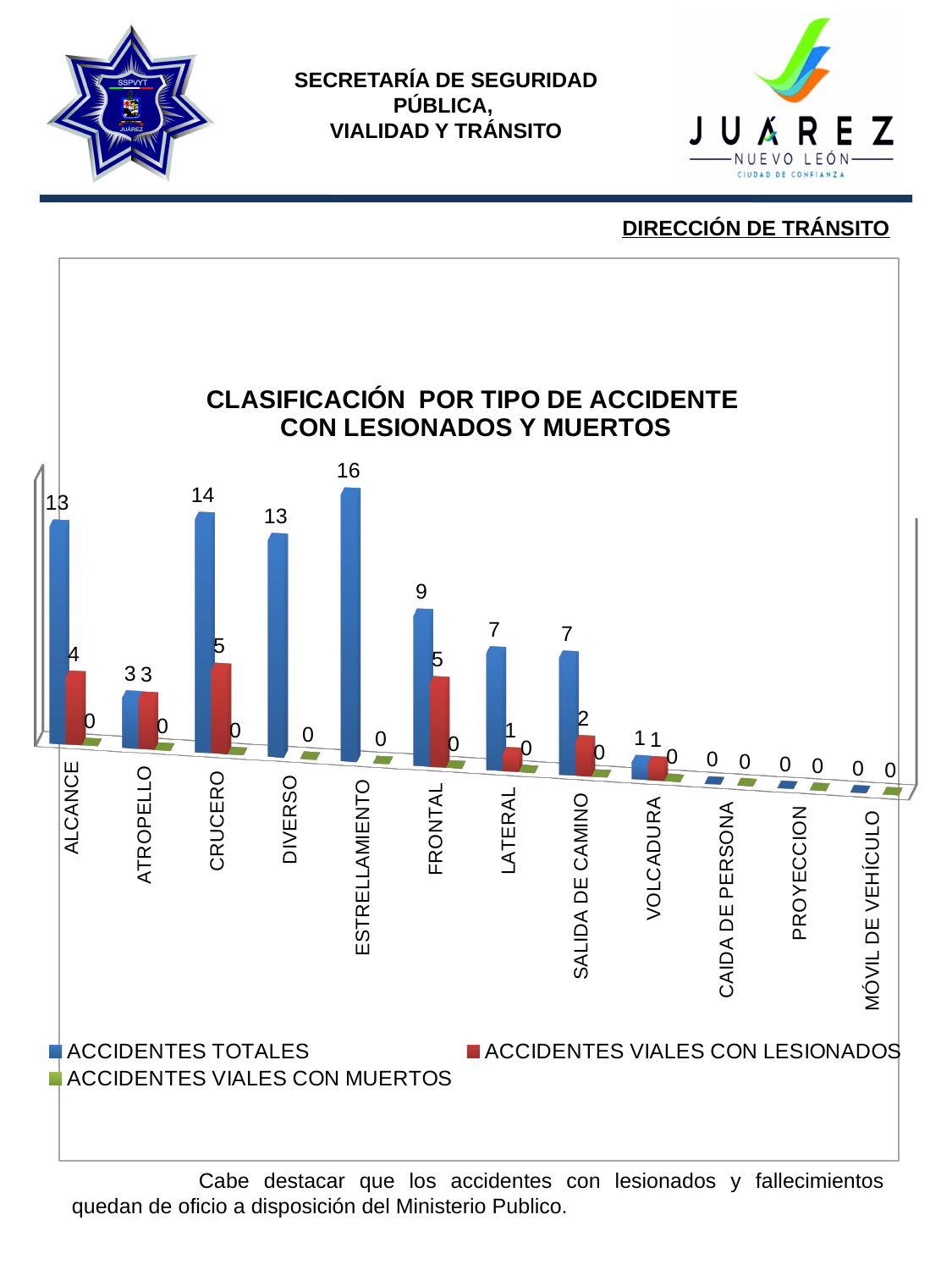
What is the value of ACCIDENTES TOTALES for ESTRELLAMIENTO? 16 What is the difference between ACCIDENTES TOTALES and ACCIDENTES VIALES CON LESIONADOS for ALCANCE? 9 What is the value of ACCIDENTES VIALES CON LESIONADOS for SALIDA DE CAMINO? 2 What kind of chart is shown on the slide? Bar chart Which category has the highest value for ACCIDENTES TOTALES? ESTRELLAMIENTO What is the value of ACCIDENTES TOTALES for VOLCADURA? 1 What is the value of ACCIDENTES VIALES CON LESIONADOS for FRONTAL? 5 How many accident categories are shown on the x axis? 12 What is the value of ACCIDENTES VIALES CON LESIONADOS for CRUCERO? 5 How many series does the legend list? 3 Which has the larger value for ACCIDENTES TOTALES, CRUCERO or ALCANCE? CRUCERO What colour represents ACCIDENTES VIALES CON MUERTOS in the legend? Green